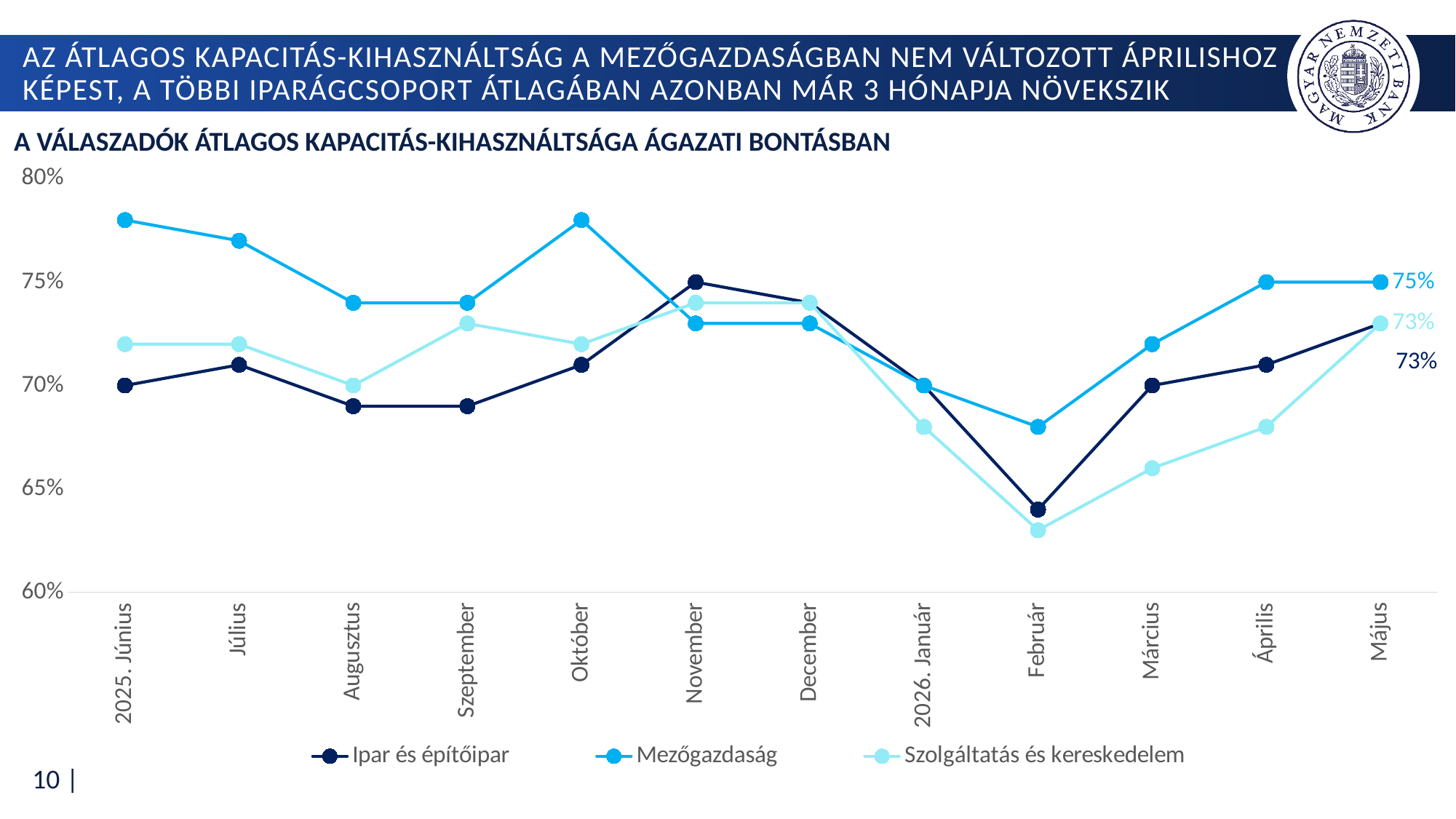
What is the value for Mezőgazdaság in Május? 75% What is the difference between the Mezőgazdaság and Ipar és építőipar values in Május? 2 percentage points How many months are plotted along the x axis? 12 What is the value for Ipar és építőipar in Május? 73% How many series does the legend list? 3 What kind of chart is shown on the slide? line chart Which series has the lowest value in Február? Szolgáltatás és kereskedelem Is the value for Szolgáltatás és kereskedelem in Február greater or less than 65%? less Is the value for Mezőgazdaság in 2025. Június greater or less than 75%? greater What is the value for Szolgáltatás és kereskedelem in Május? 73% Does the Ipar és építőipar line rise or fall from Február to Május? rise Which series has the highest value in Május? Mezőgazdaság